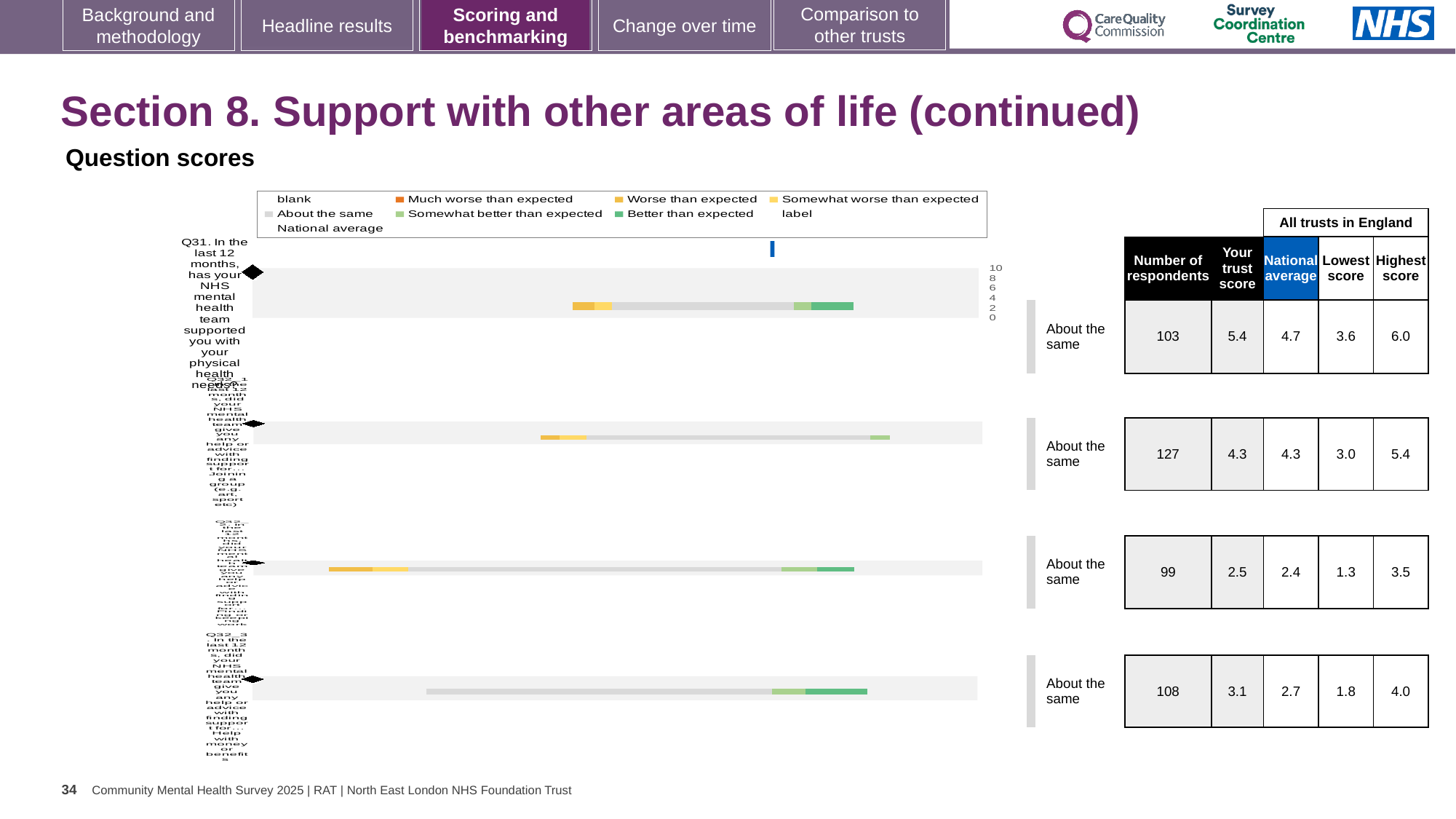
How many question bars are plotted in the chart? 4 Which row in the table has the lowest number of respondents? the third row (99) In the table next to the chart, what is the number of respondents for Q31 (the first row)? 103 In the table next to the chart, what is the highest score for the second row? 5.4 In the table next to the chart, what is the trust score for Q31 (the first row)? 5.4 In the table next to the chart, what is the lowest score for the third row? 1.3 For Q31 (the first row), what is the difference between the trust score and the national average? 0.7 What kind of chart is shown on the slide? bar chart For the fourth row, which is larger: the trust score or the national average? the trust score (3.1) In the table next to the chart, what is the national average for the first row (Q31)? 4.7 What is the title of the chart section shown above the chart? Question scores Which row in the table has the highest trust score? the first row, Q31 (5.4)